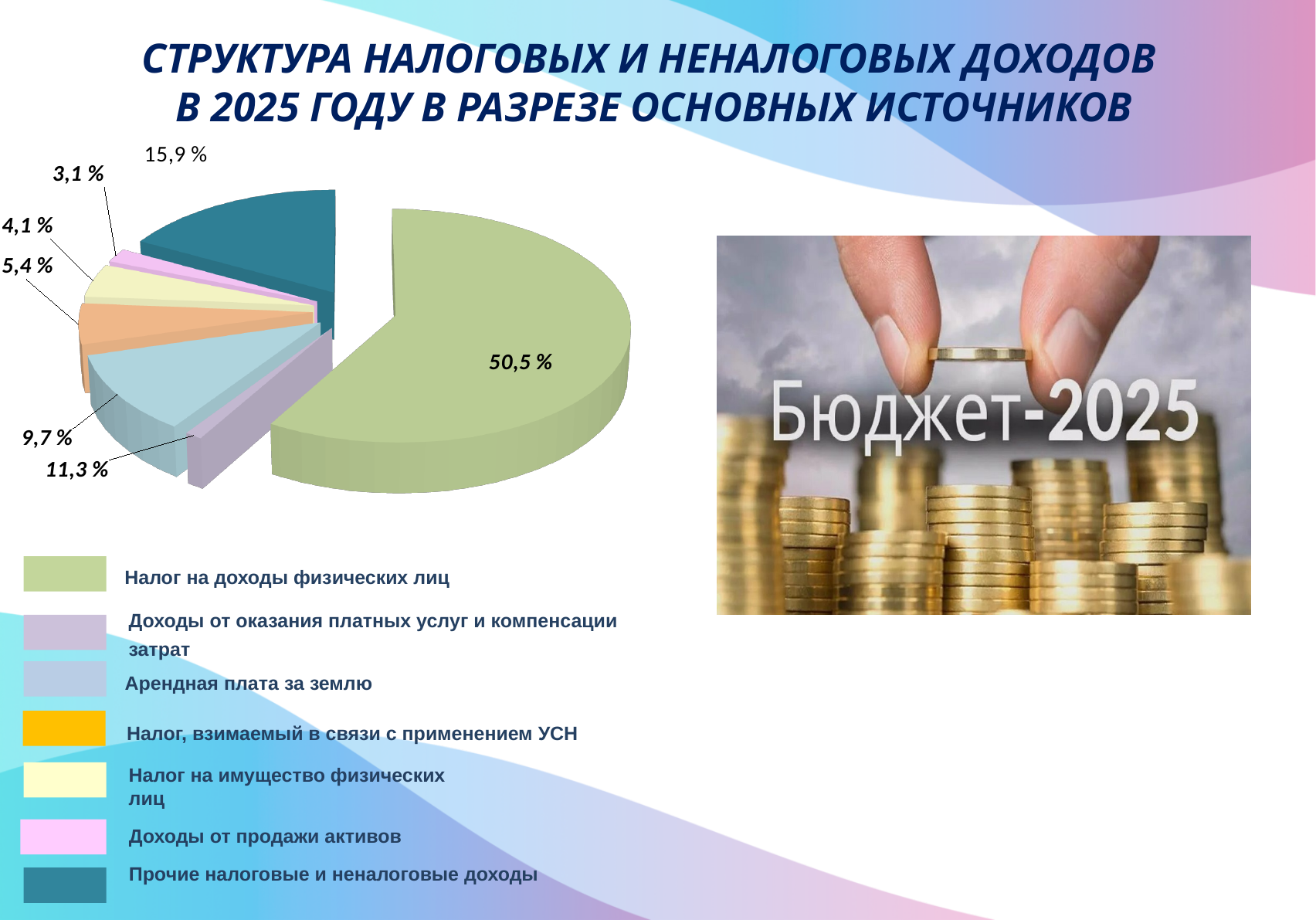
What share of the pie does "Налог на доходы физических лиц" have? 50,5 % How many categories does the pie chart have? 7 What colour is the slice for "Прочие налоговые и неналоговые доходы"? Teal (dark blue-green) Which category has the smallest share of the pie? Доходы от продажи активов Which is larger: the share of "Доходы от оказания платных услуг и компенсации затрат" or the share of "Арендная плата за землю"? Доходы от оказания платных услуг и компенсации затрат What share of the pie does "Арендная плата за землю" have? 9,7 % What share of the pie does "Доходы от продажи активов" have? 3,1 % What share of the pie does "Прочие налоговые и неналоговые доходы" have? 15,9 % What share of the pie does "Налог, взимаемый в связи с применением УСН" have? 5,4 % Which category has the largest share of the pie? Налог на доходы физических лиц What is the difference in percentage points between "Налог на доходы физических лиц" and "Прочие налоговые и неналоговые доходы"? 34,6 What type of chart is shown on the slide? Pie chart